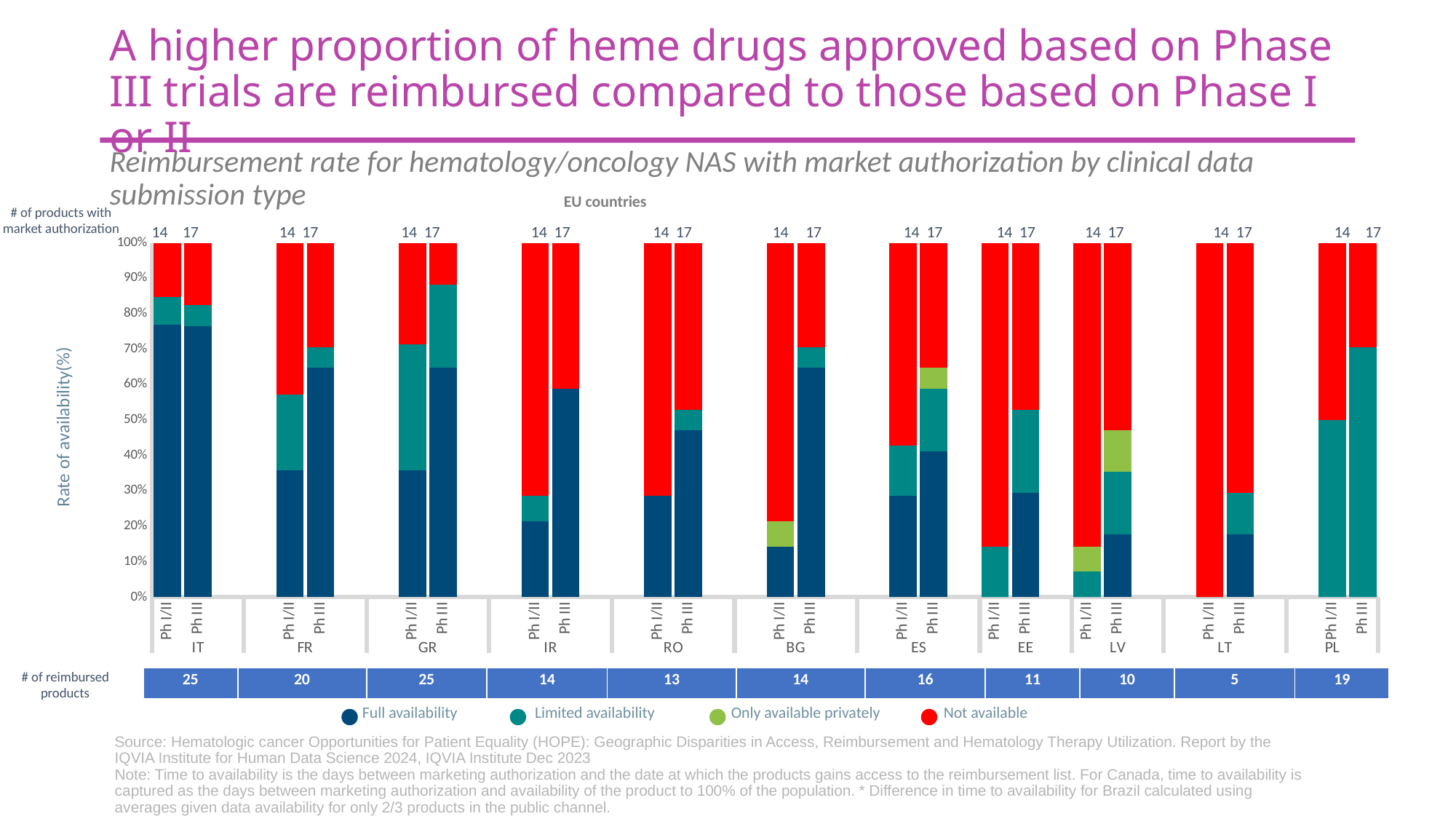
How many products with market authorization are shown above each Ph III bar? 17 What is the number of reimbursed products shown for LT? 5 How many EU countries are shown on the x axis of the chart? 11 Which colour represents 'Not available' in the legend? Red What kind of chart is shown on the slide? Stacked bar chart Is the Not available share for the LT Ph I/II bar greater or less than 90%? greater Is the Full availability share for the IT Ph I/II bar greater or less than 70%? greater What is the number of reimbursed products shown for IT? 25 Which country has the lowest number of reimbursed products? LT What is the difference between the number of reimbursed products for IT and for LT? 20 For FR, which bar has the larger Full availability share, Ph I/II or Ph III? Ph III How many series does the chart legend list? 4